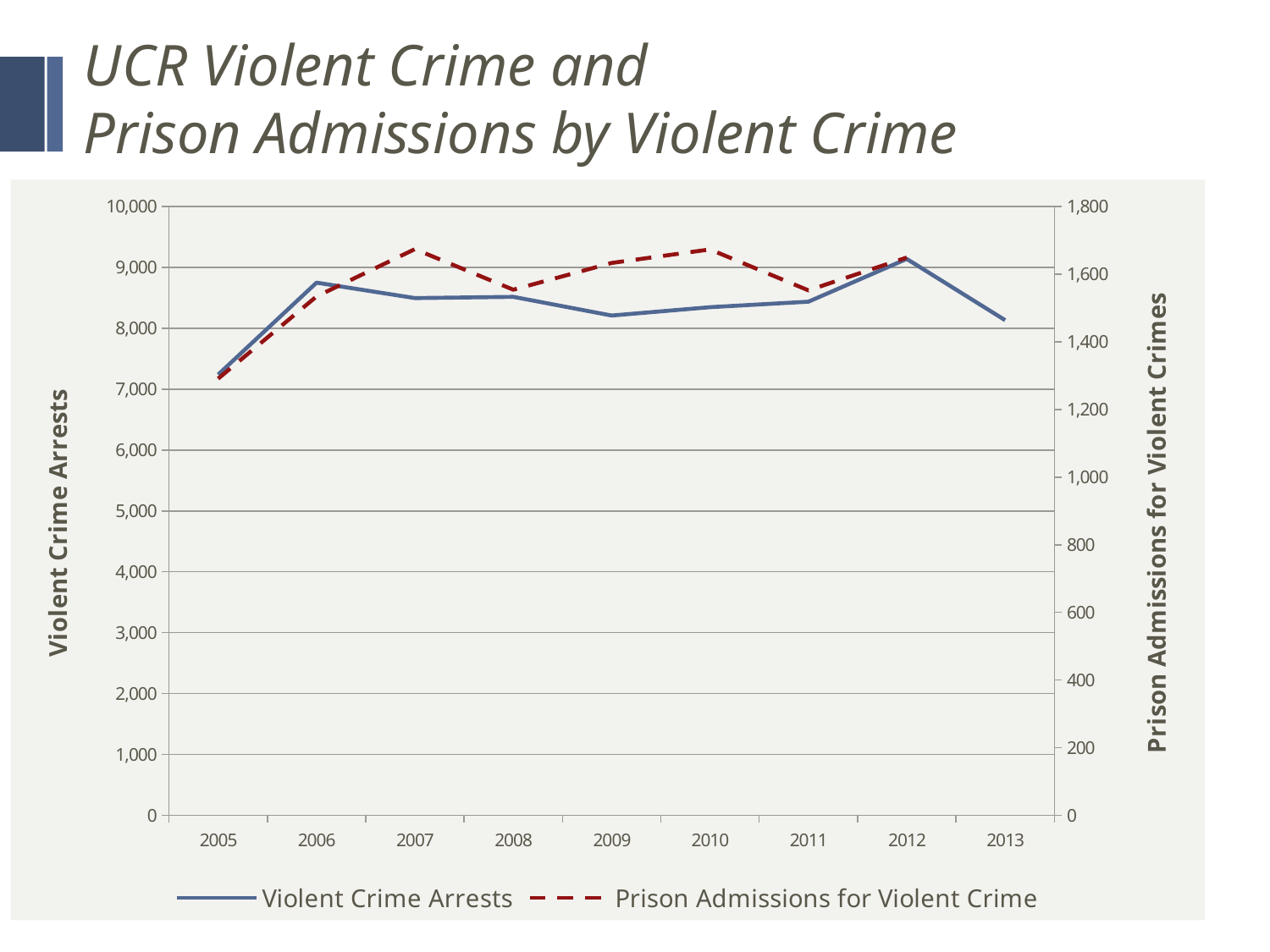
What is the title of the right-hand vertical axis? Prison Admissions for Violent Crimes Does the Prison Admissions for Violent Crime line rise or fall from 2005 to 2006? rise How many series does the legend list? 2 Is the value for Prison Admissions for Violent Crime in 2007 greater or less than 1,600? greater Is the value for Violent Crime Arrests in 2009 greater or less than 9,000? less In which year is the Violent Crime Arrests line at its highest? 2012 Is the value for Violent Crime Arrests in 2005 greater or less than 7,000? greater What kind of chart is shown on the slide? line chart How many years are shown on the x axis? 9 Does the Violent Crime Arrests line rise or fall from 2012 to 2013? fall In which year is the Prison Admissions for Violent Crime line at its lowest? 2005 In which year is the Violent Crime Arrests line at its lowest? 2005